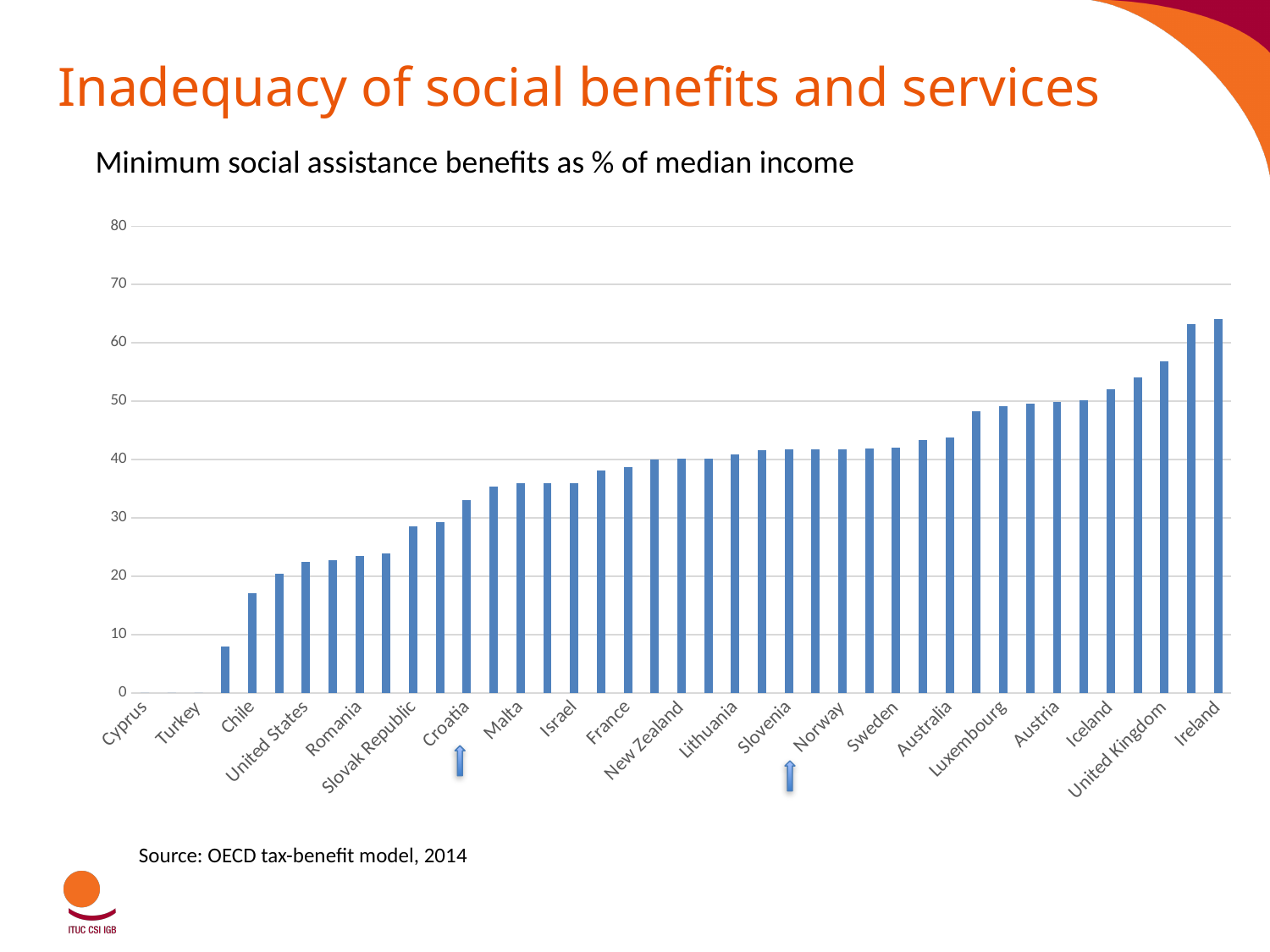
Which country has the highest minimum social assistance benefit as % of median income? Ireland Which has a higher value, France or Sweden? Sweden Do the values generally rise or fall from left to right along the x axis? rise What is the source cited for the chart? OECD tax-benefit model, 2014 What kind of chart is shown on the slide? bar chart Is the value for Croatia greater or less than 20? greater Is the value for Chile greater or less than 10? greater Which has a higher value, Austria or Romania? Austria Is the value for United States greater or less than 30? less